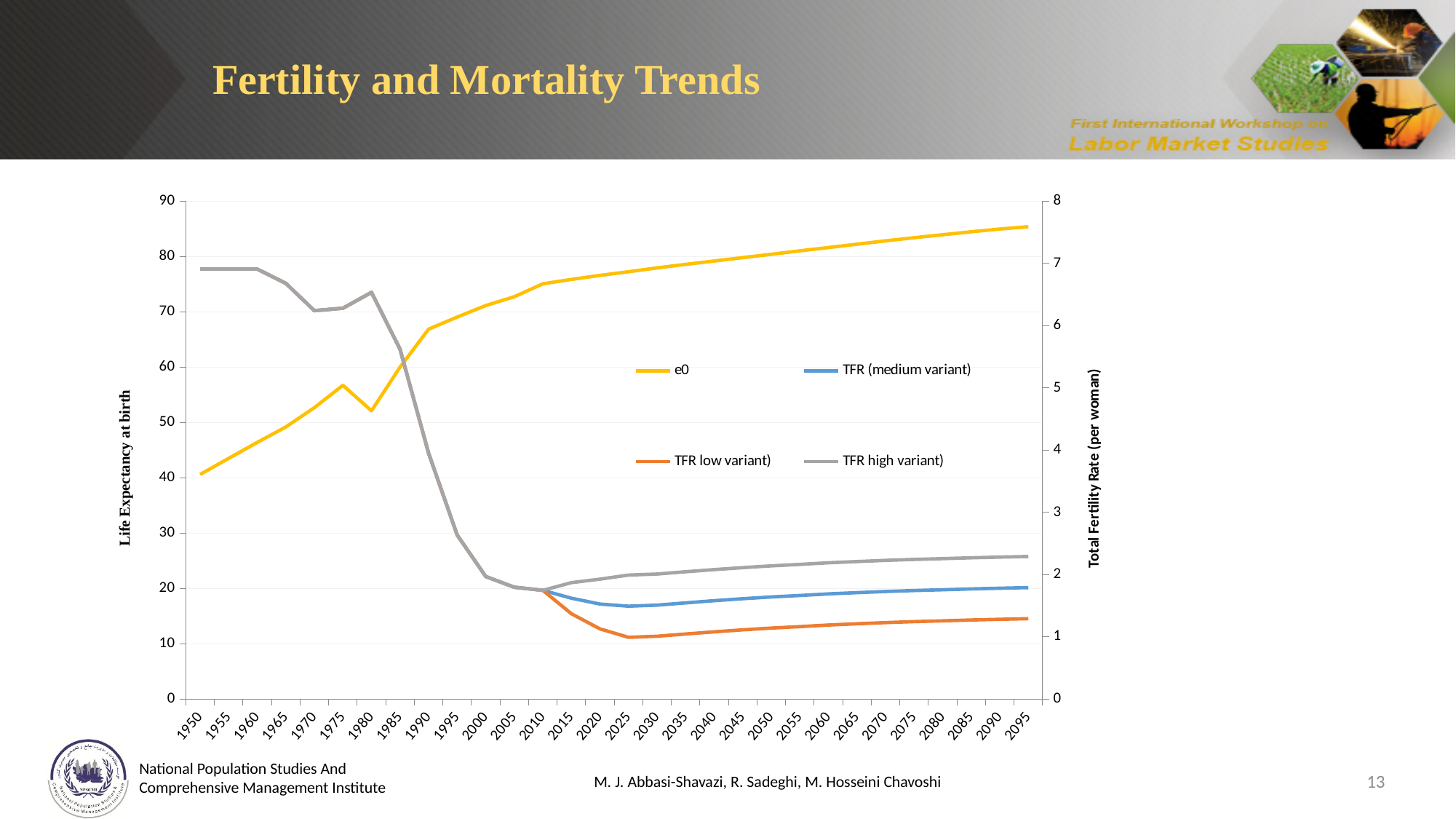
What kind of chart is shown on the slide? line chart Is the value of e0 in 1950 greater or less than 50 on the left axis? less In 2095, which is higher: TFR high variant or TFR low variant? TFR high variant What is the title of the right-hand vertical axis? Total Fertility Rate (per woman) Is the TFR high variant value in 1950 greater or less than 6 on the right axis? greater Does the TFR high variant series rise or fall between 1950 and 2010? fall How many series does the legend list? 4 Does the e0 series rise or fall from 1950 to 2095? rise Is the value of e0 in 1980 greater or less than 60 on the left axis? less How many years are labelled along the x axis? 30